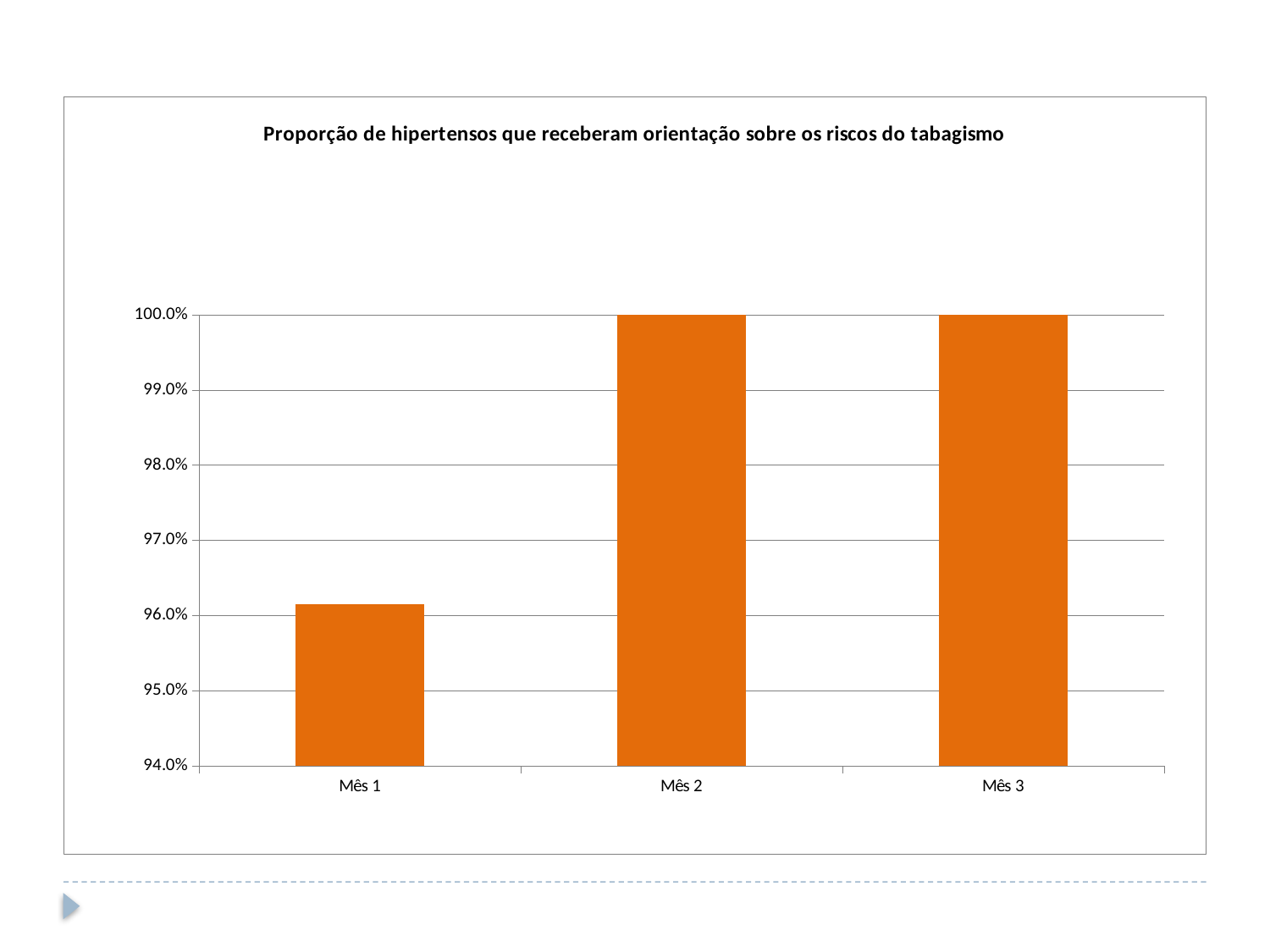
Which is larger, the value for Mês 1 or the value for Mês 2? Mês 2 Which month has the lowest value? Mês 1 What is the value for Mês 2? 100.0% What is the title of the chart? Proporção de hipertensos que receberam orientação sobre os riscos do tabagismo Is the value for Mês 1 greater or less than 97.0%? less Is the value for Mês 1 greater or less than 95.0%? greater Does the value rise or fall from Mês 1 to Mês 2? rise What kind of chart is shown on the slide? bar chart What is the difference between the values for Mês 2 and Mês 3? 0.0% What is the lowest value shown on the y axis? 94.0% How many categories are plotted on the x axis? 3 What is the value for Mês 3? 100.0%